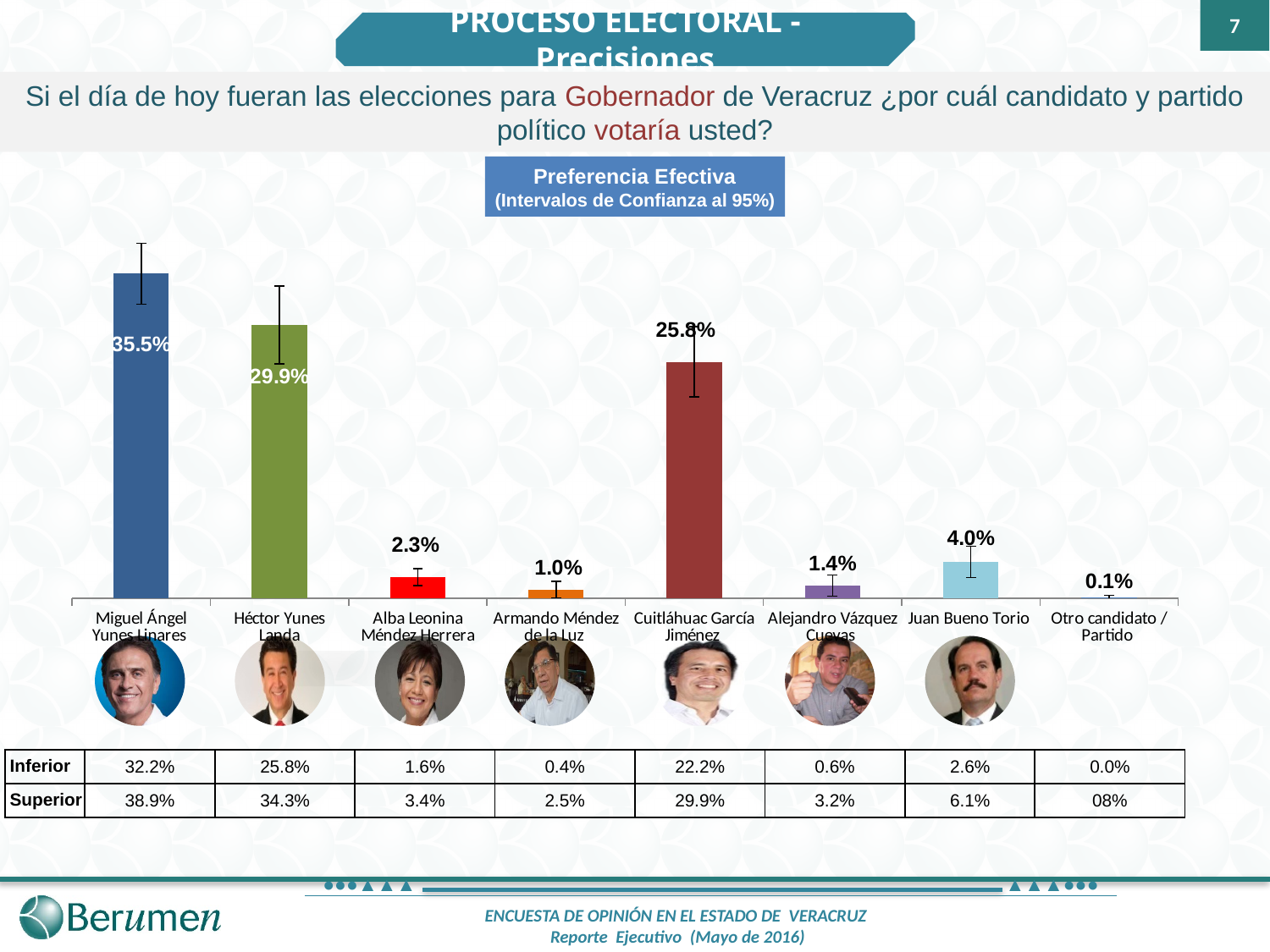
What is the value for Cuitláhuac García Jiménez? 25.8% Which candidate has the highest value? Miguel Ángel Yunes Linares What is the value for Juan Bueno Torio? 4.0% Which is larger, the value for Alba Leonina Méndez Herrera or the value for Alejandro Vázquez Cuevas? Alba Leonina Méndez Herrera What kind of chart is shown on the slide? Bar chart What is the 'Superior' confidence interval value for Héctor Yunes Landa? 34.3% What is the title of the chart? Preferencia Efectiva (Intervalos de Confianza al 95%) Which category has the lowest value? Otro candidato / Partido What is the value for Miguel Ángel Yunes Linares? 35.5% What is the 'Inferior' confidence interval value for Cuitláhuac García Jiménez? 22.2% How many candidate categories are shown in the chart? 8 What is the difference between the values for Miguel Ángel Yunes Linares and Héctor Yunes Landa? 5.6%